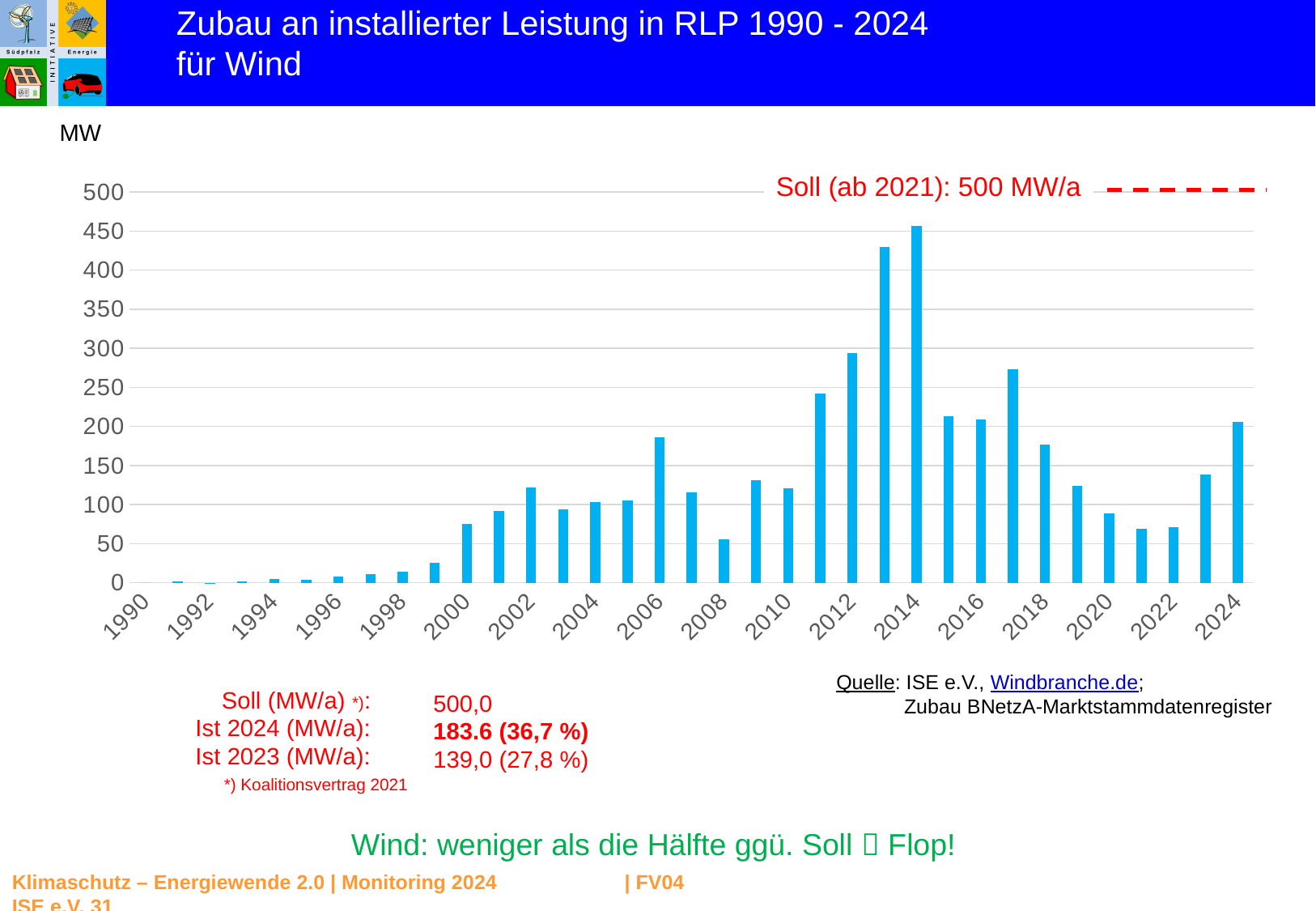
Is the value for 2017 greater or less than 250? greater Is the value for 1998 greater or less than 50? less Is the value for 2014 greater or less than 400? greater Which year has the highest bar in the chart? 2014 What value does the slide give for Ist 2023 (MW/a)? 139,0 What kind of chart is shown on the slide? bar chart Do the values rise or fall from 2014 to 2016? fall What target value (Soll) per year is shown by the dashed red line? 500 MW/a Which is larger, the value for 2017 or the value for 2018? 2017 Which is larger, the value for 2013 or the value for 2014? 2014